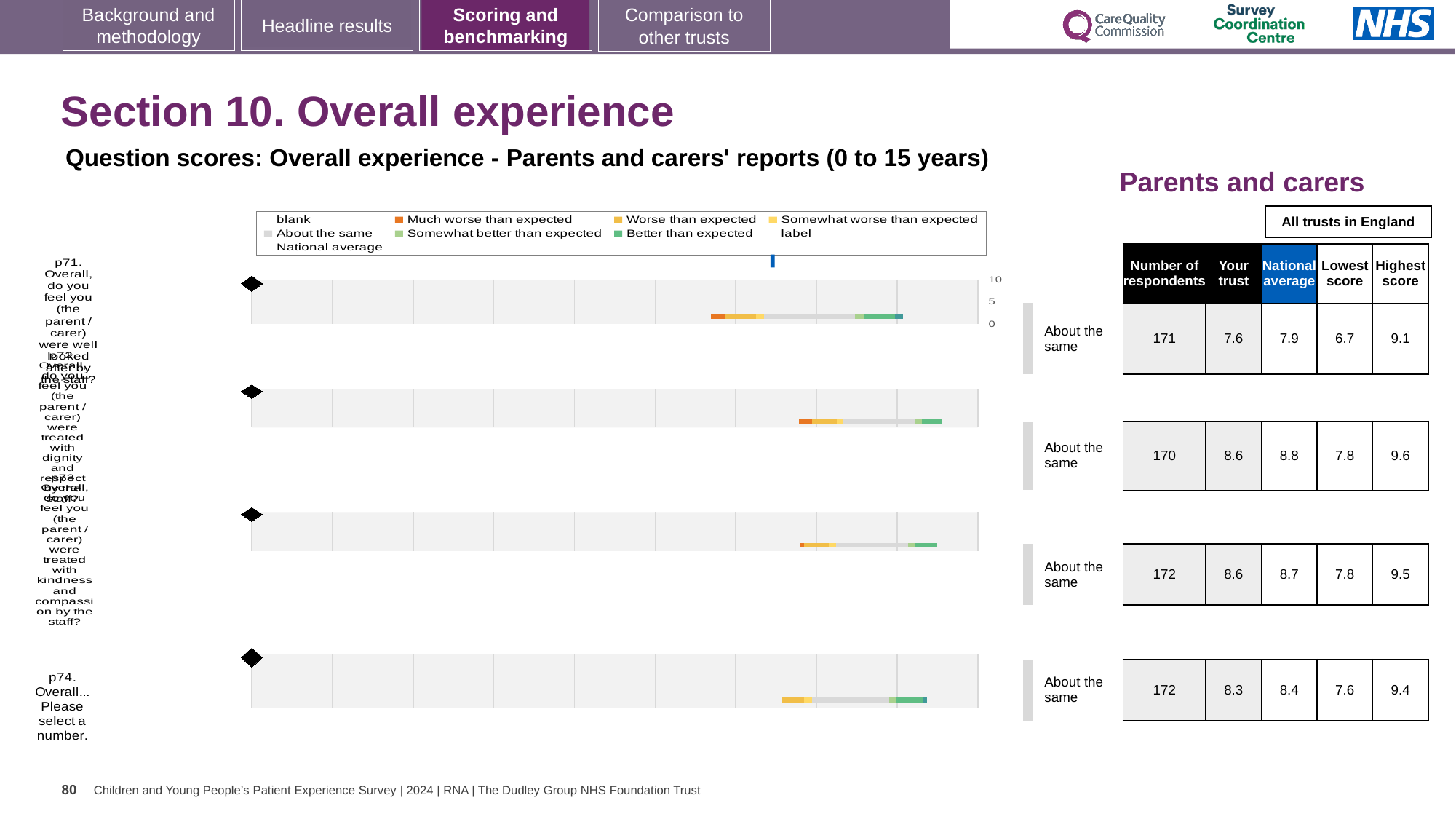
Which question has the lowest 'Your trust' score? p71 What benchmark category is shown for p74? About the same What is the title of the chart? Question scores: Overall experience - Parents and carers' reports (0 to 15 years) What is the national average score for p71? 7.9 What is the 'Your trust' score for p74 (Overall... Please select a number)? 8.3 What is the difference between the highest score and the lowest score for p71? 2.4 What kind of chart is shown on the slide? bar chart How many respondents answered p74? 172 How many entries does the chart legend list? 9 How many question bars are plotted in the chart? 4 What is the 'Your trust' score for p71 (Overall, do you feel you were well looked after by the staff?)? 7.6 For p71, which is larger: the 'Your trust' score or the national average? National average